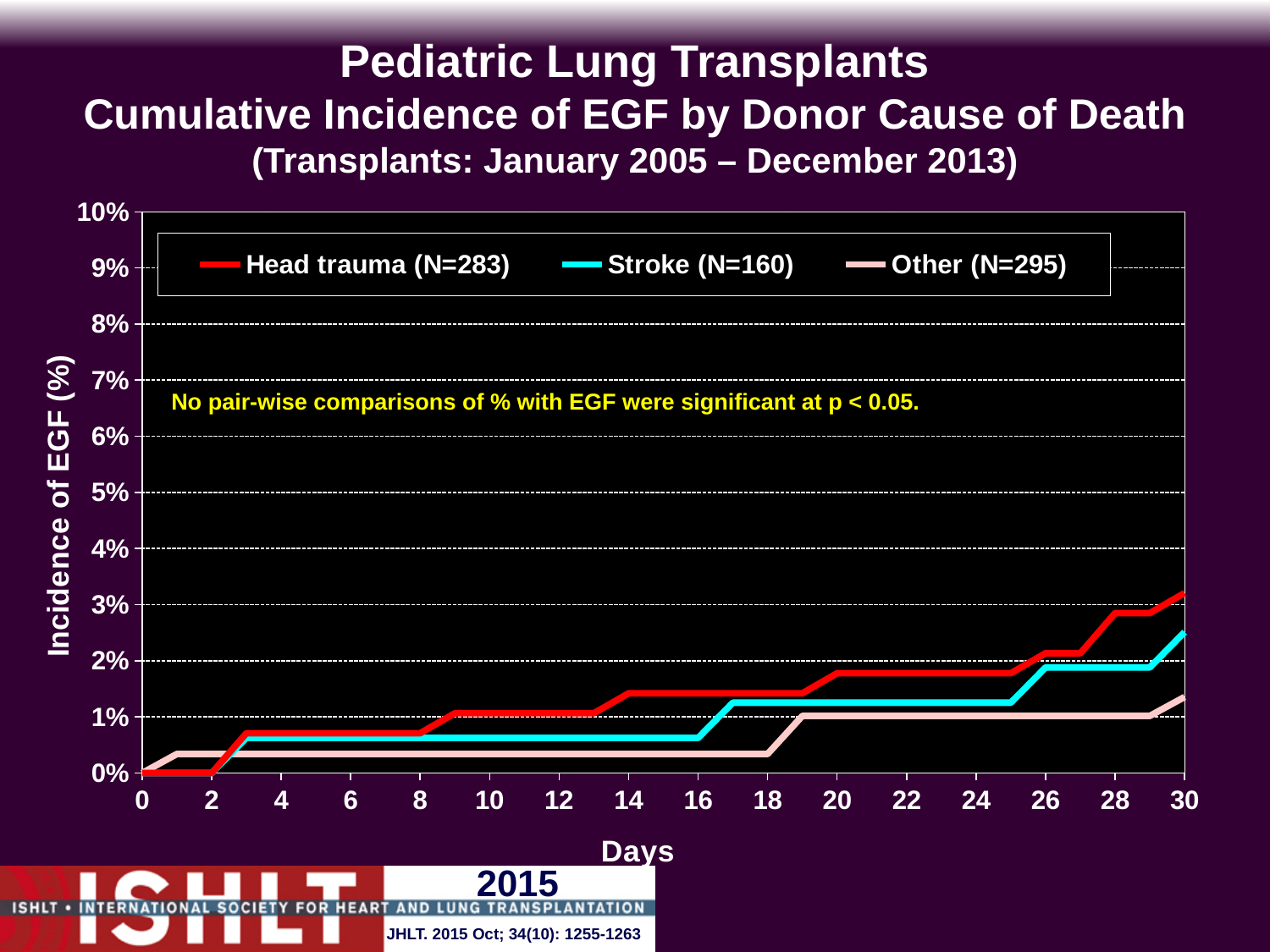
Do the cumulative incidence values rise or fall as the number of days increases? rise How many series does the legend list? 3 Is the cumulative incidence of EGF for Other at day 30 greater or less than 2%? less Which donor cause of death group has the highest cumulative incidence of EGF at day 30? Head trauma (N=283) Is the cumulative incidence of EGF for Head trauma at day 30 greater or less than 2%? greater At day 30, which is larger: the cumulative incidence of EGF for Head trauma or for Stroke? Head trauma Is the cumulative incidence of EGF for Stroke at day 10 greater or less than 1%? less What is the sample size (N) shown in the legend for the Stroke group? 160 Which donor cause of death group has the lowest cumulative incidence of EGF at day 30? Other (N=295) What is the label of the y axis? Incidence of EGF (%) What kind of chart is shown on the slide? Line chart